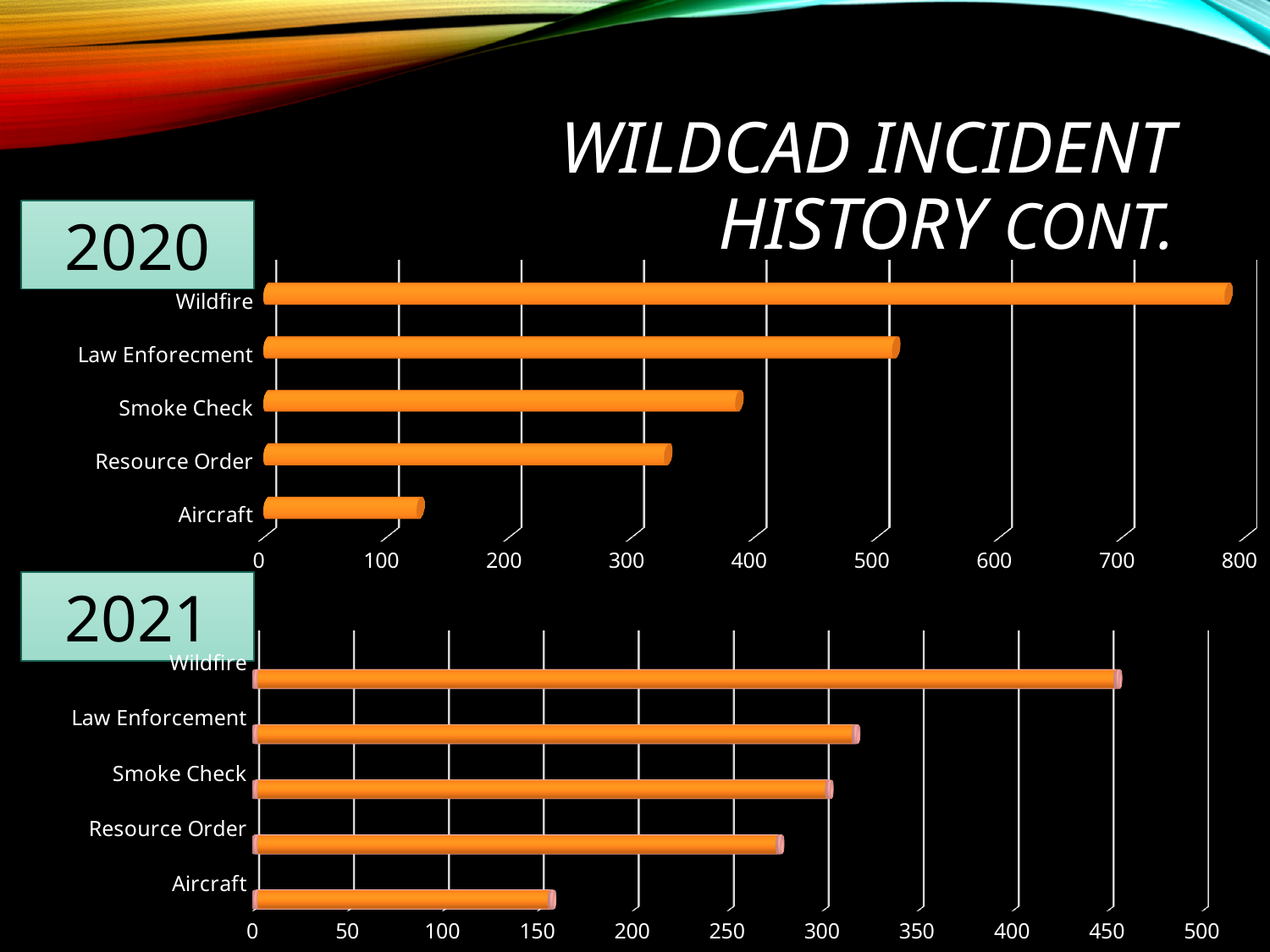
In the 2020 chart, is the value for Aircraft greater or less than 100? greater In the 2020 chart, which category has the lowest value? Aircraft In the 2021 chart, which category has the highest value? Wildfire In the 2020 chart, which category has the highest value? Wildfire In the 2020 chart, is the value for Wildfire greater or less than 700? greater In the 2021 chart, which category has the lowest value? Aircraft In the 2020 chart, which is larger, Law Enforecment or Smoke Check? Law Enforecment How many categories are shown in the 2021 chart? 5 What kind of chart is the 2020 chart? bar chart In the 2020 chart, is the value for Resource Order greater or less than 400? less